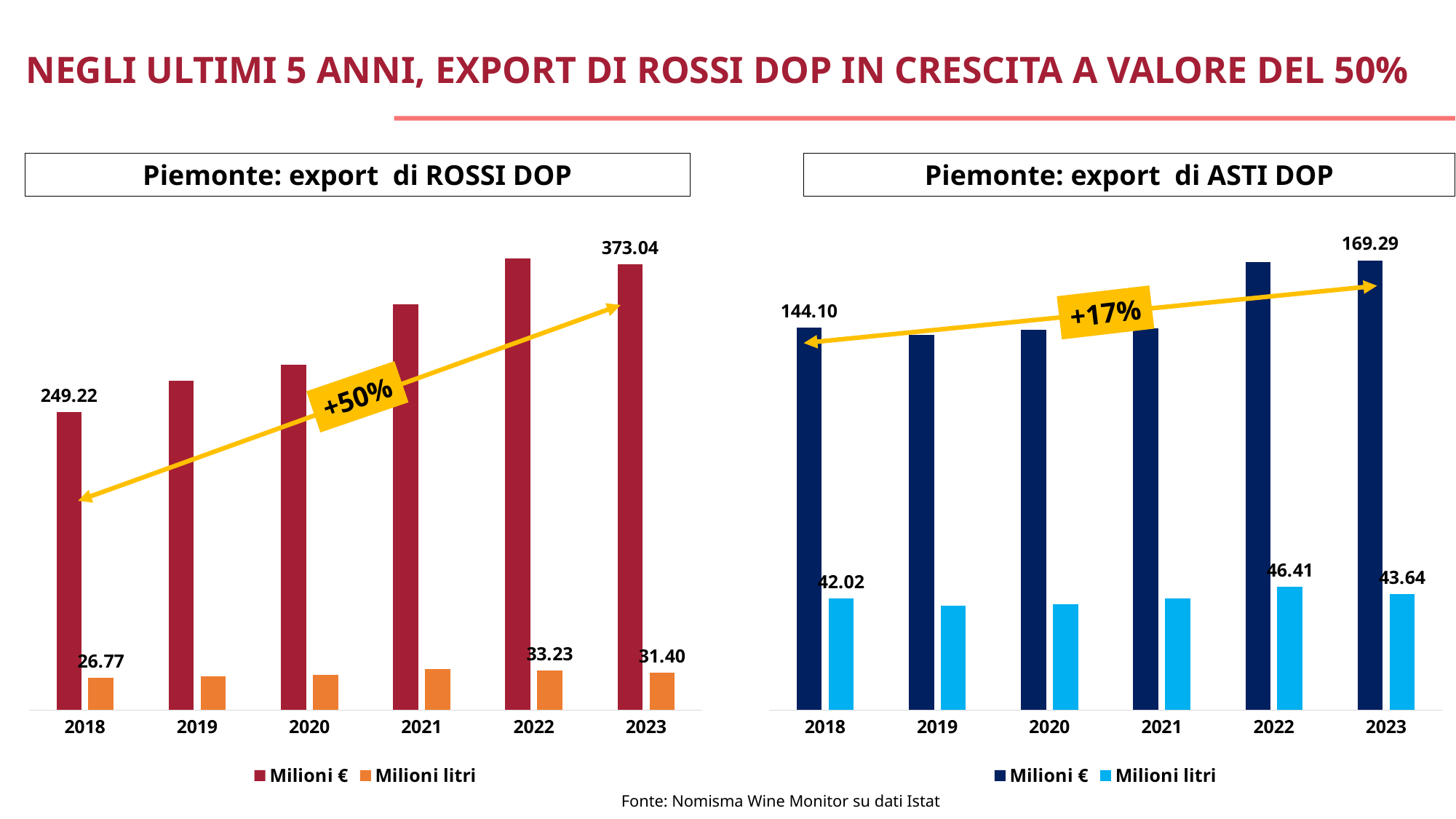
In the 'Piemonte: export di ASTI DOP' chart, what is the Milioni € value for 2018? 144.10 In the 'Piemonte: export di ROSSI DOP' chart, by how much did the Milioni € value increase from 2018 to 2023? 123.82 In the 'Piemonte: export di ROSSI DOP' chart, which year has the lowest Milioni € value? 2018 Which is larger: the 2023 Milioni € value in the ROSSI DOP chart or the 2023 Milioni € value in the ASTI DOP chart? ROSSI DOP (373.04) In the 'Piemonte: export di ASTI DOP' chart, which year has the highest Milioni litri value? 2022 How many years are shown on the x axis of the 'Piemonte: export di ROSSI DOP' chart? 6 In the 'Piemonte: export di ASTI DOP' chart, what is the Milioni litri value for 2022? 46.41 In the 'Piemonte: export di ASTI DOP' chart, what is the difference between the Milioni € values for 2023 and 2018? 25.19 In the 'Piemonte: export di ROSSI DOP' chart, what is the Milioni € value for 2018? 249.22 What type of chart is 'Piemonte: export di ROSSI DOP'? Bar chart How many series does the legend of the 'Piemonte: export di ASTI DOP' chart list? 2 In the 'Piemonte: export di ROSSI DOP' chart, what is the Milioni € value for 2023? 373.04